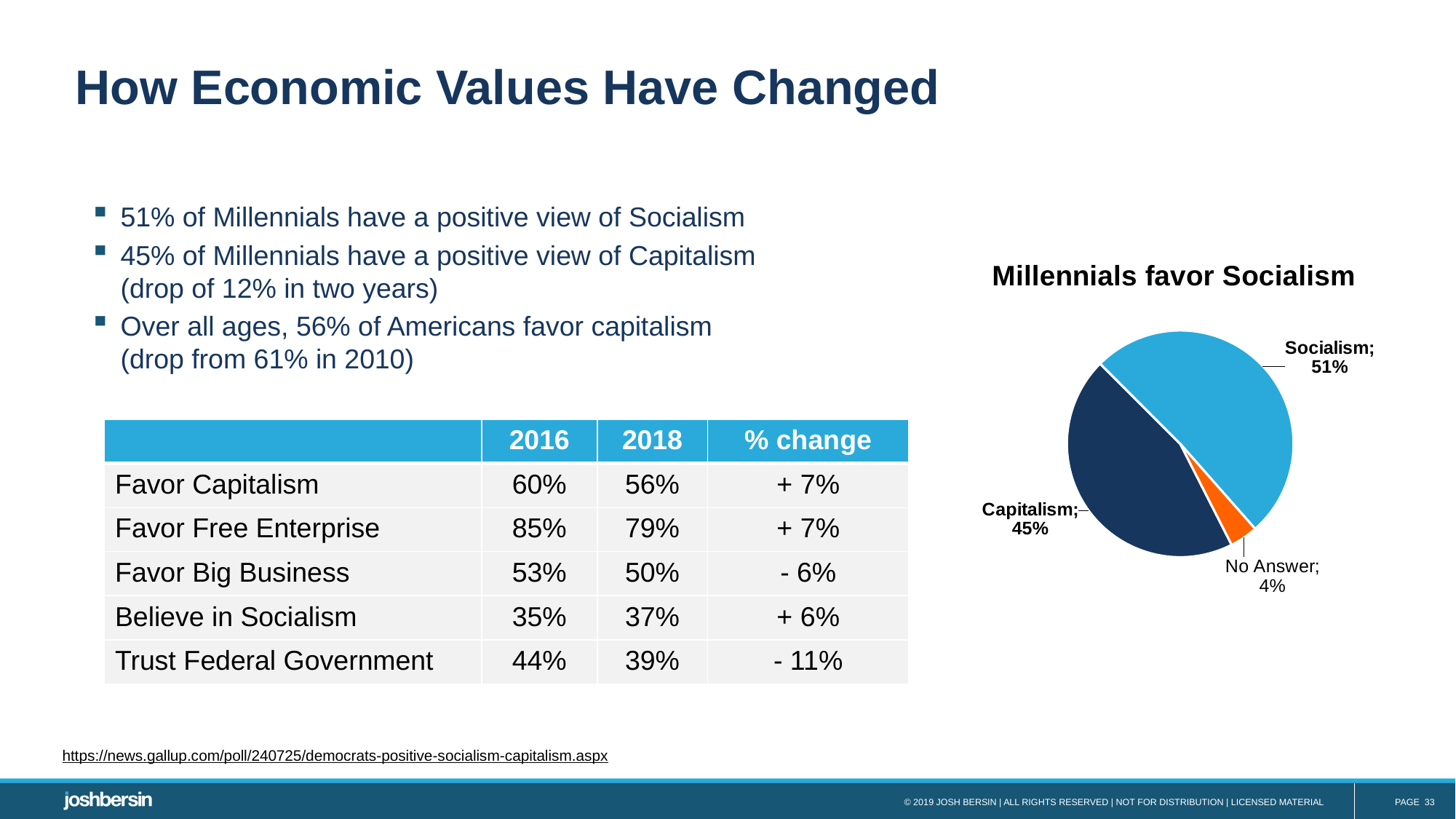
What is the difference between the Socialism and Capitalism slices? 6% Which is larger, the Capitalism slice or the No Answer slice? Capitalism Which slice of the pie is the smallest? No Answer Which slice of the pie is the largest? Socialism What share of the pie is labelled No Answer? 4% What is the difference between the Capitalism and No Answer slices? 41% What is the title of the chart? Millennials favor Socialism What colour is the Socialism slice of the pie? light blue What share of the pie is labelled Socialism? 51% How many slices does the pie chart have? 3 What type of chart is shown on the slide? pie chart What share of the pie is labelled Capitalism? 45%